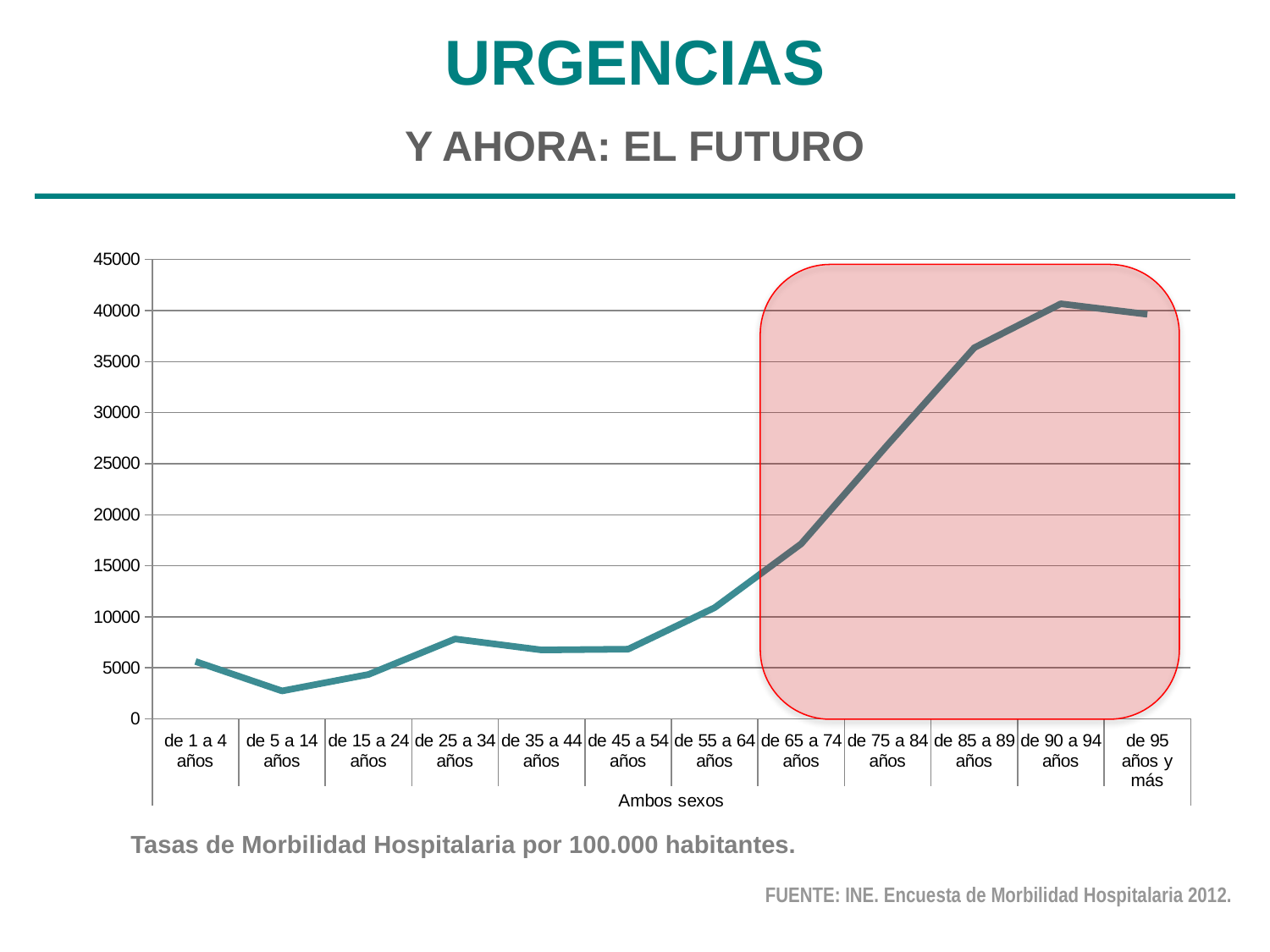
Which age category has the highest value? de 90 a 94 años Do the values rise or fall from de 55 a 64 años to de 90 a 94 años? rise Which age category has the lowest value? de 5 a 14 años Is the value for de 75 a 84 años greater or less than 25000? greater Is the value for de 65 a 74 años greater or less than 15000? greater What is the label shown under the x axis of the chart? Ambos sexos Is the value for de 85 a 89 años greater or less than 40000? less Which has the larger value, de 1 a 4 años or de 5 a 14 años? de 1 a 4 años What kind of chart is shown on the slide? line chart How many age categories are plotted along the x axis? 12 Which has the larger value, de 65 a 74 años or de 45 a 54 años? de 65 a 74 años